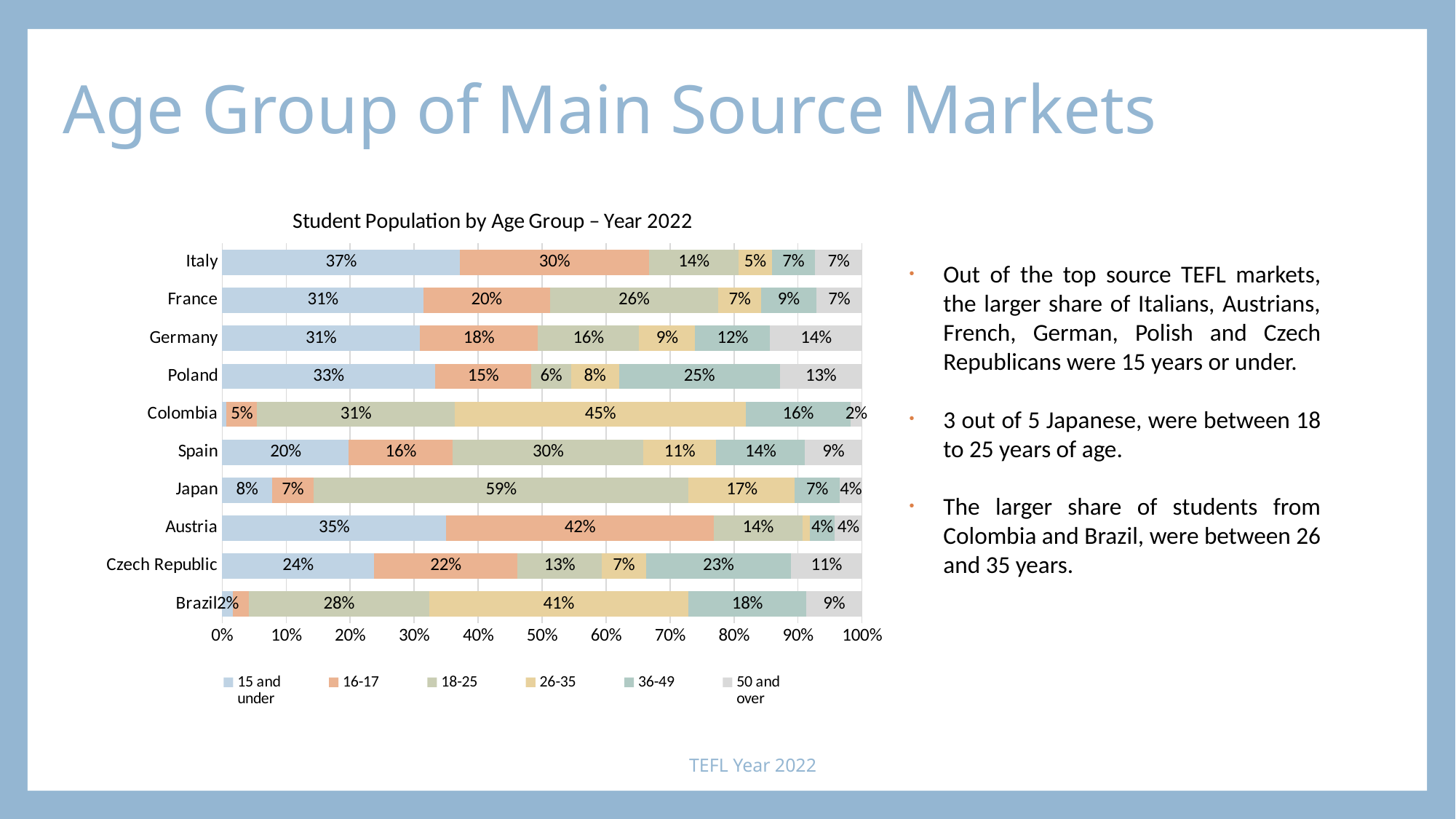
Which has a larger 36-49 share, Poland or the Czech Republic? Poland Which country has the highest share of students in the 18-25 age group? Japan How many age groups does the legend list? 6 How many percentage points higher is Italy's 15 and under share than Japan's 15 and under share? 29 percentage points What is the difference between Austria's and Italy's 16-17 shares? 12 percentage points What is the 50 and over share for Germany? 14% In the Student Population by Age Group chart, what percentage of students from Japan are in the 18-25 age group? 59% What type of chart is used to show the student population by age group? Stacked bar chart What percentage of students from Italy are 15 and under? 37% Which country has the largest share of students aged 16-17? Austria How many countries are shown in the chart? 10 What share of students from Colombia fall in the 26-35 age group? 45%